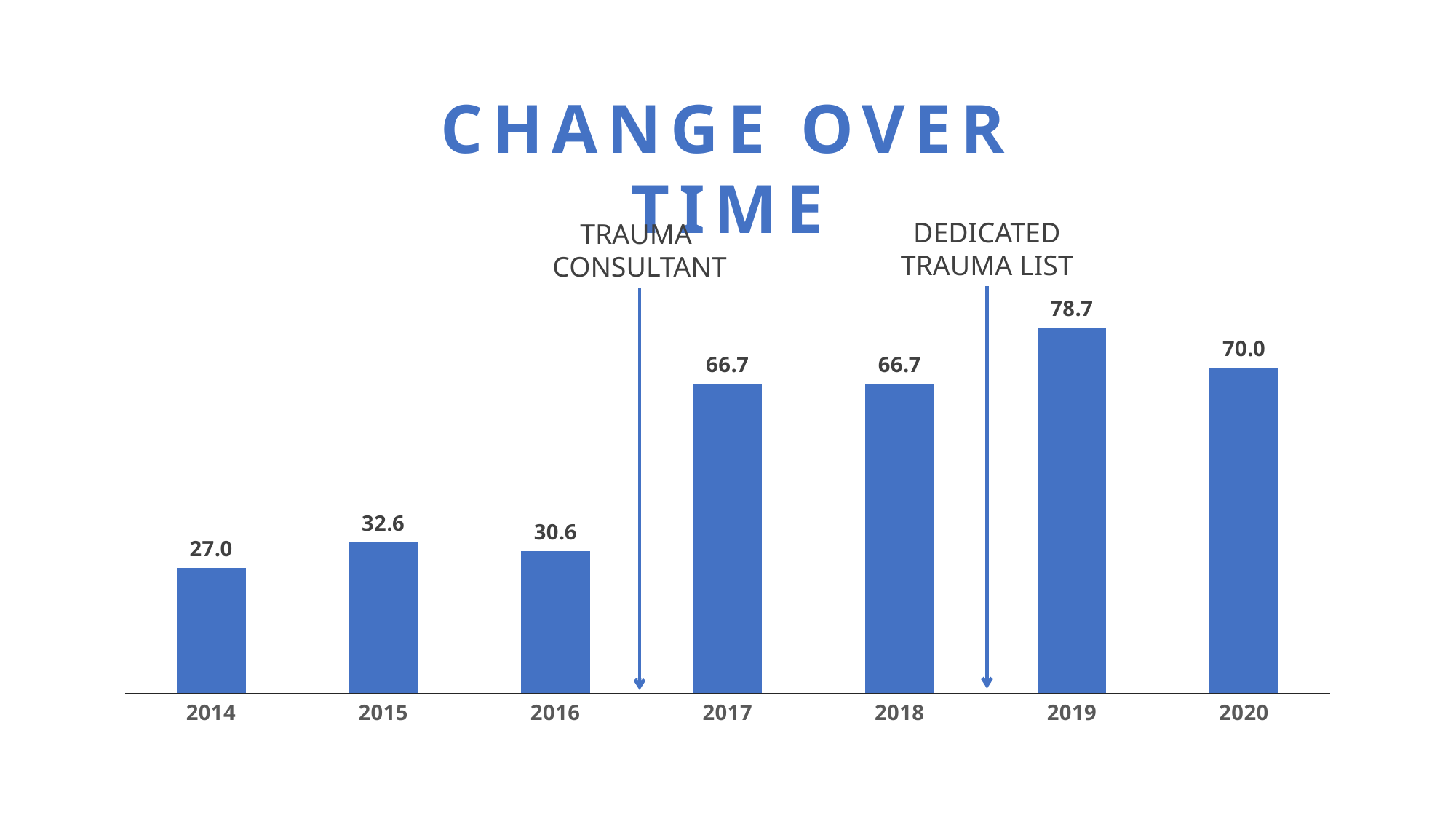
Which is larger, the value for 2015 or the value for 2016? 2015 Which year has the highest value? 2019 What is the value for 2014? 27.0 What is the difference between the values for 2019 and 2020? 8.7 How many years are shown on the x axis? 7 Which year has the lowest value? 2014 What is the title of the chart? CHANGE OVER TIME What is the difference between the values for 2017 and 2016? 36.1 What is the value for 2017? 66.7 What kind of chart is shown on the slide? Bar chart What annotation is placed between 2018 and 2019? DEDICATED TRAUMA LIST What is the value for 2019? 78.7